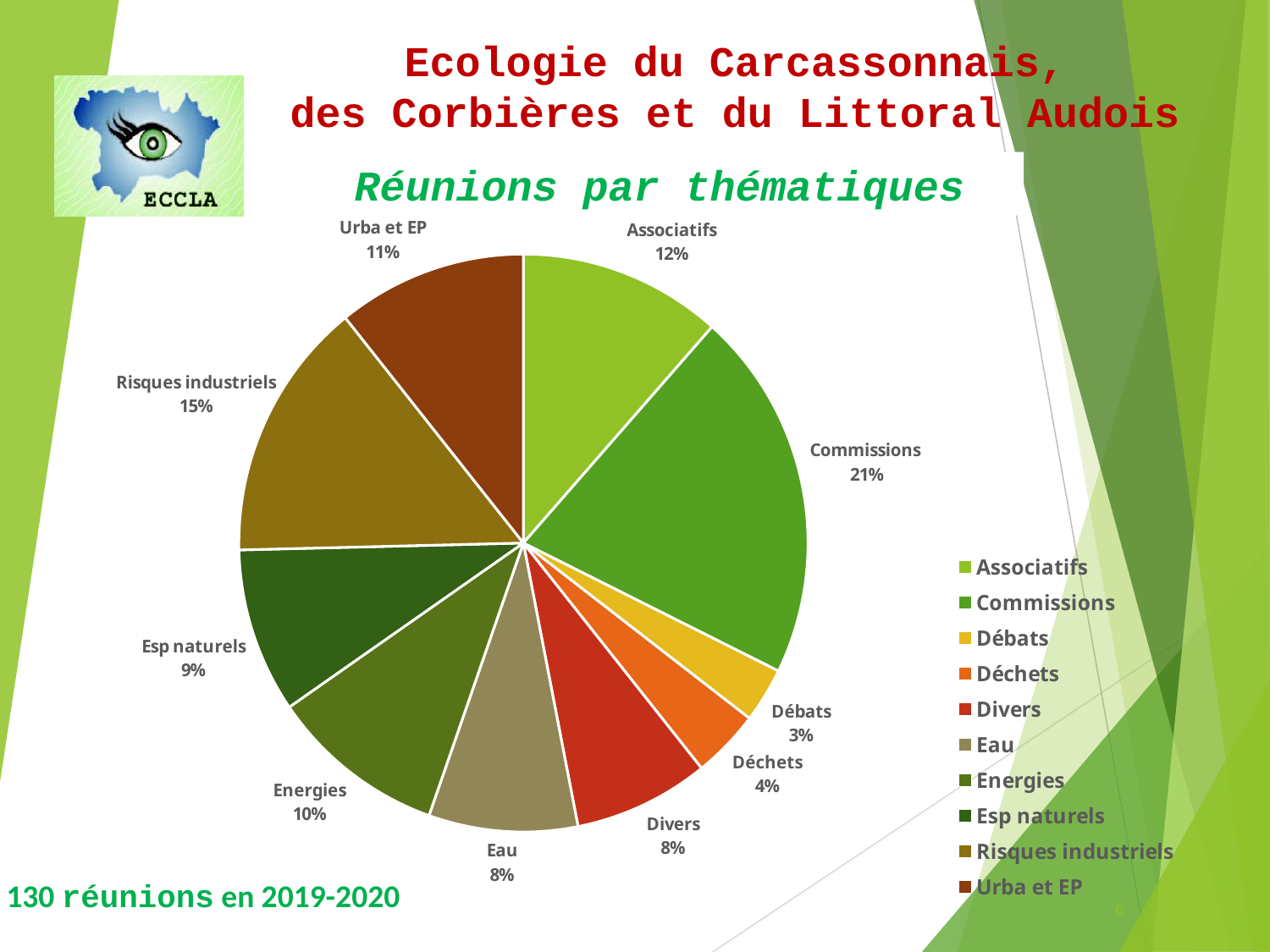
What is the value shown for Risques industriels? 15% Which is larger, the share for Energies or the share for Esp naturels? Energies What is the value shown for Urba et EP? 11% What kind of chart is shown on the slide? pie chart What is the difference in percentage points between Commissions and Associatifs? 9 What is the value shown for Débats? 3% Which category has the smallest slice of the pie? Débats What is the title of the chart? Réunions par thématiques Which category has the largest slice of the pie? Commissions How many categories are shown in the pie chart? 10 What share of the pie does Commissions represent? 21% How many entries does the legend list? 10